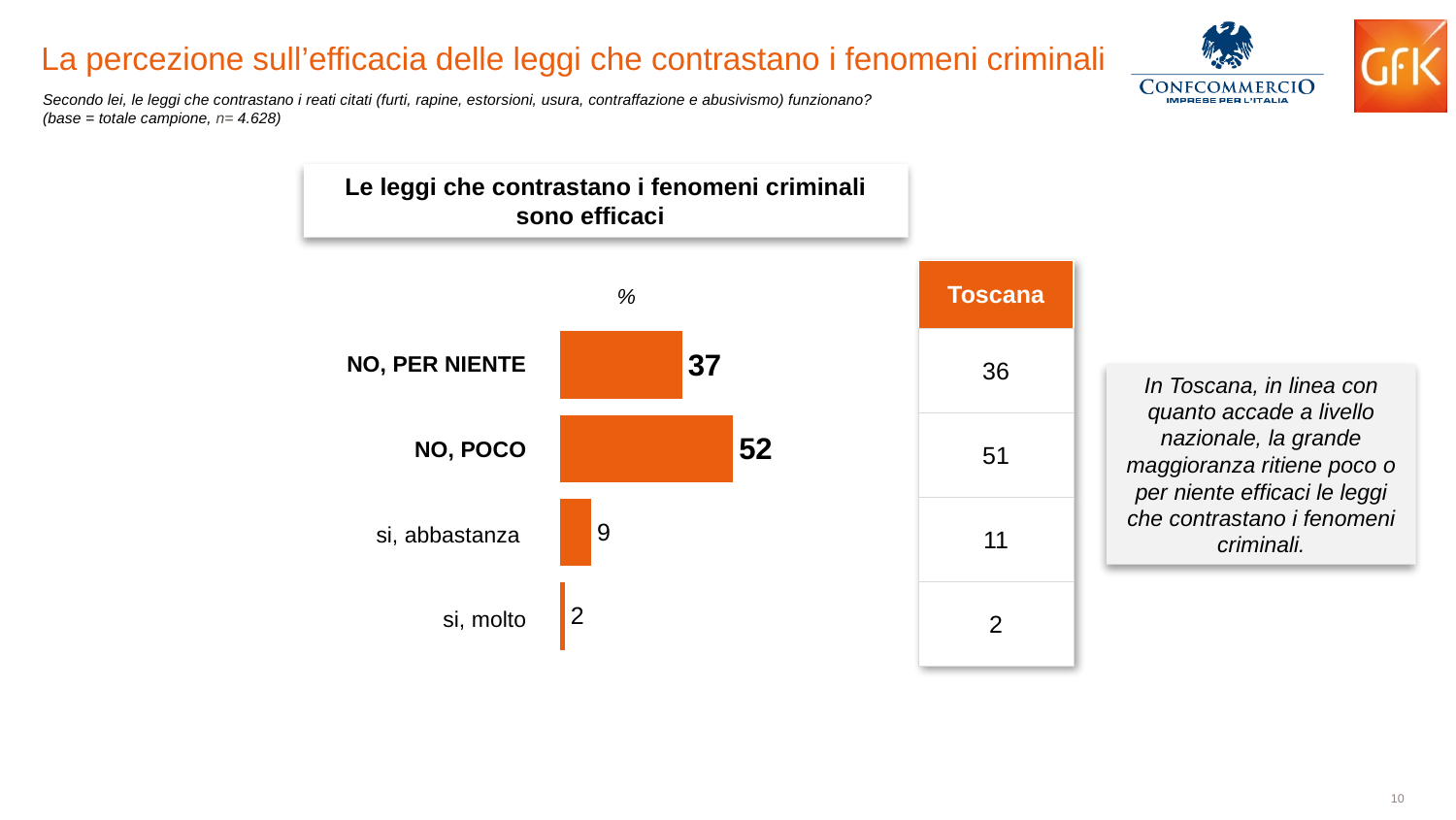
What is the difference between the values for si, abbastanza and si, molto? 7 What is the value for si, molto in the chart? 2 Which category has the lowest value in the chart? si, molto What is the title of the chart? Le leggi che contrastano i fenomeni criminali sono efficaci What is the value for NO, POCO in the chart? 52 What is the difference between the values for NO, POCO and NO, PER NIENTE? 15 What is the value for NO, PER NIENTE in the chart? 37 What is the value for si, abbastanza in the chart? 9 Which category has the highest value in the chart? NO, POCO How many categories are shown in the chart? 4 Which is larger, the value for si, abbastanza or the value for si, molto? si, abbastanza What kind of chart is shown on the slide? Bar chart